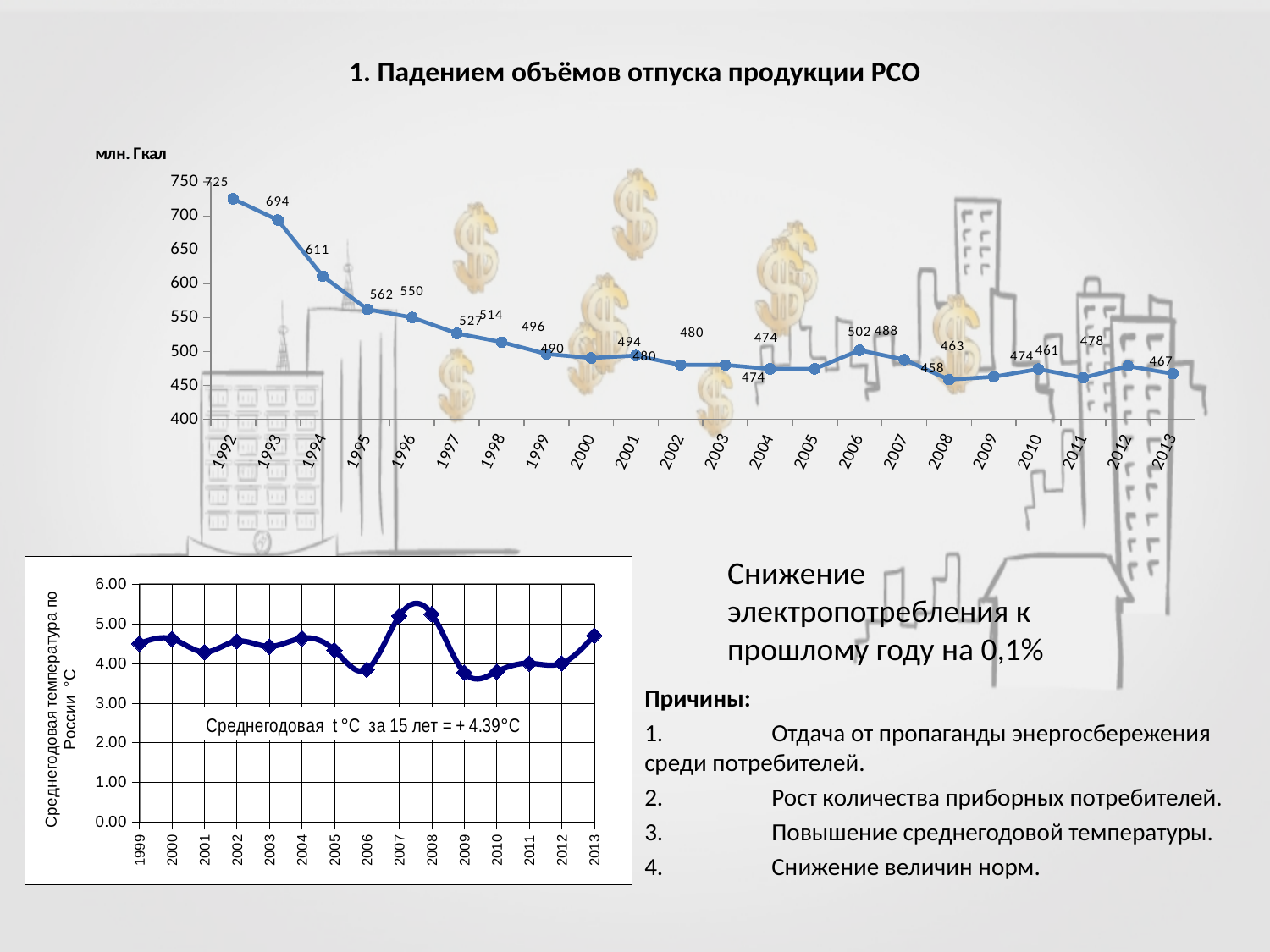
In the top chart (млн. Гкал), which is larger, the value for 1995 or the value for 1996? 1995 What kind of chart is the top chart (млн. Гкал)? line chart In the top chart (млн. Гкал), what is the value for 1994? 611 In the bottom chart (Среднегодовая температура по России), what average annual temperature over 15 years is stated in the text inside the chart? + 4.39°C In the top chart (млн. Гкал), what is the value for 1992? 725 In the top chart (млн. Гкал), which year has the highest value? 1992 In the top chart (млн. Гкал), what is the value for 2013? 467 In the bottom chart (Среднегодовая температура по России), is the value for 2006 greater or less than 4.00? less In the top chart (млн. Гкал), do the values generally rise or fall from 1992 to 2013? fall In the top chart (млн. Гкал), how many years are plotted on the x axis? 22 In the bottom chart (Среднегодовая температура по России), how many years are plotted on the x axis? 15 In the top chart (млн. Гкал), what is the difference between the values for 1992 and 1993? 31